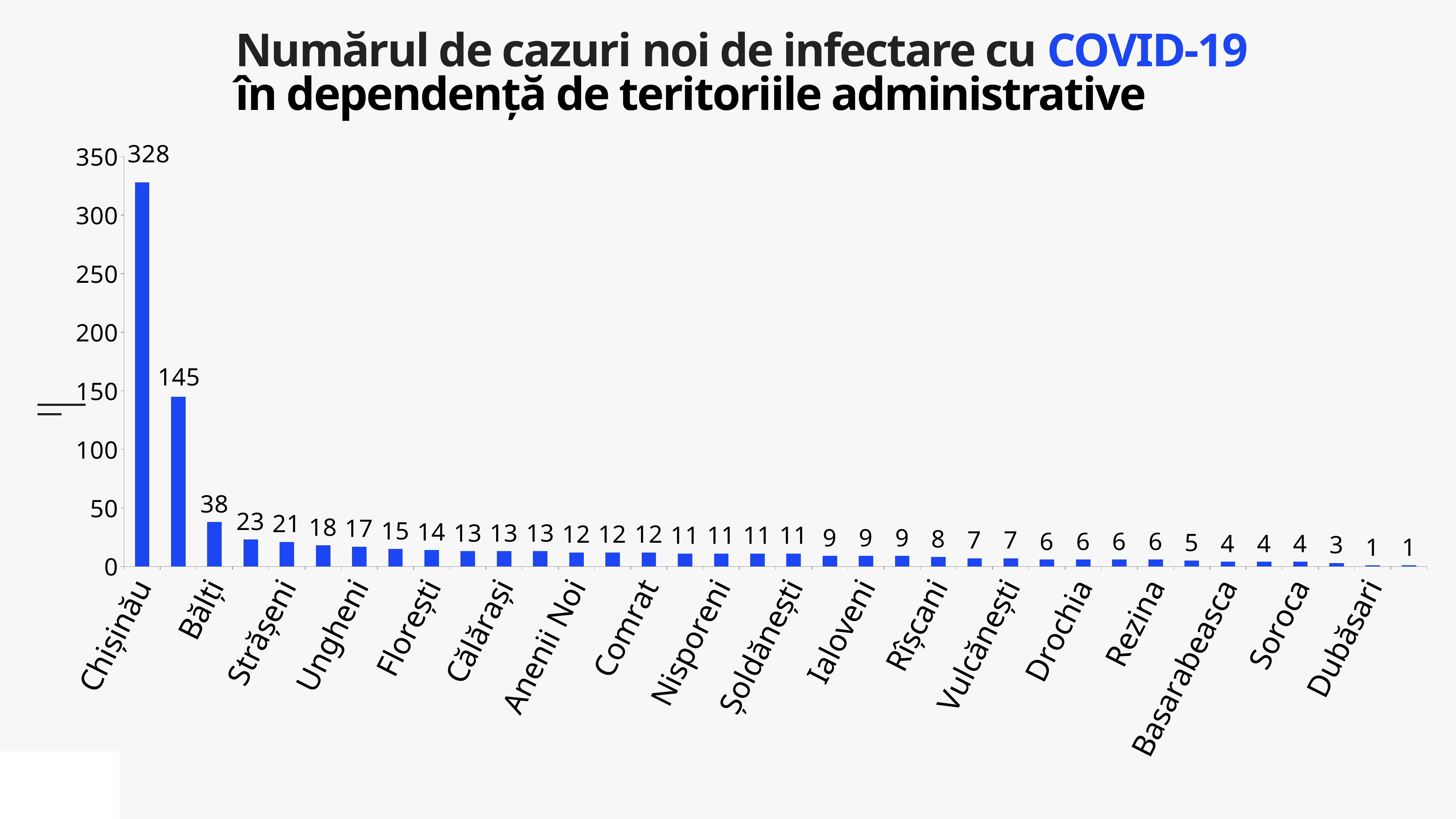
Do the values rise or fall from left to right along the x axis? fall What is the difference between the two tallest bars in the chart? 183 What is the value of the second tallest bar in the chart? 145 What is the highest tick value shown on the vertical axis? 350 Which territory has the highest number of new COVID-19 cases? Chișinău What colour are the bars in the chart? blue What is the smallest value shown on any bar in the chart? 1 How many bars are plotted in the chart? 36 Is the value for Chișinău greater or less than 300? greater What kind of chart is shown on the slide? bar chart How many bars have a value above 100? 2 How many new COVID-19 cases are shown for Chișinău? 328